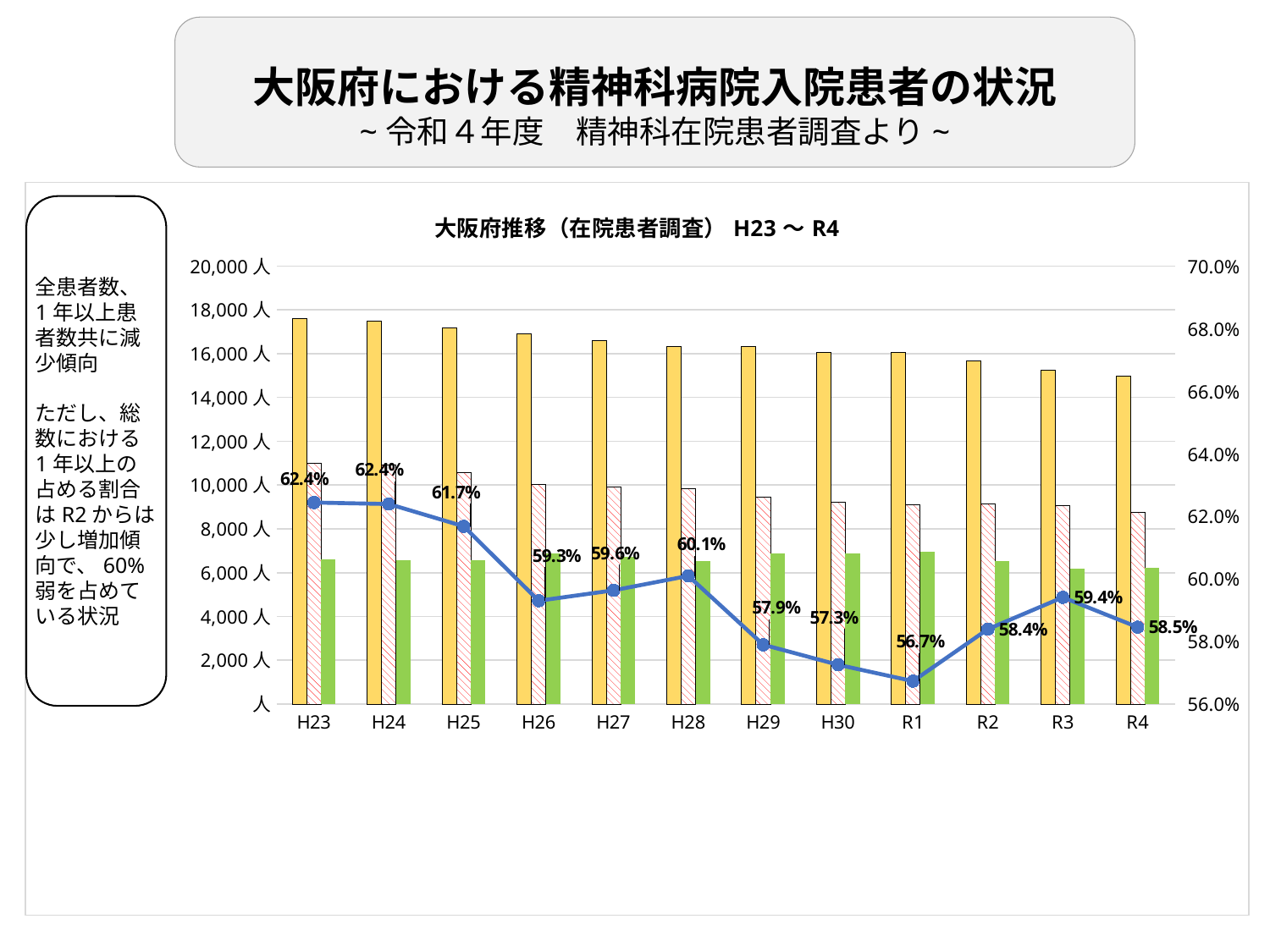
Which year has the lowest percentage value on the line series? R1 Is the value of the yellow bar for R4 greater or less than 16,000人? less What is the title of the chart? 大阪府推移（在院患者調査） H23 〜 R4 Does the yellow bar series rise or fall from H23 to R4? fall What is the percentage value shown for R4 on the line series? 58.5% Is the value of the yellow bar for H23 greater or less than 16,000人? greater What is the percentage value shown for R1 on the line series? 56.7% Which is larger, the line series percentage for H28 or for H27? H28 What is the difference between the line series percentage for H23 and for R1? 5.7% How many years are shown on the x axis? 12 What is the percentage value shown for H26 on the line series? 59.3% What is the difference between the line series percentage for R3 and for R2? 1.0%